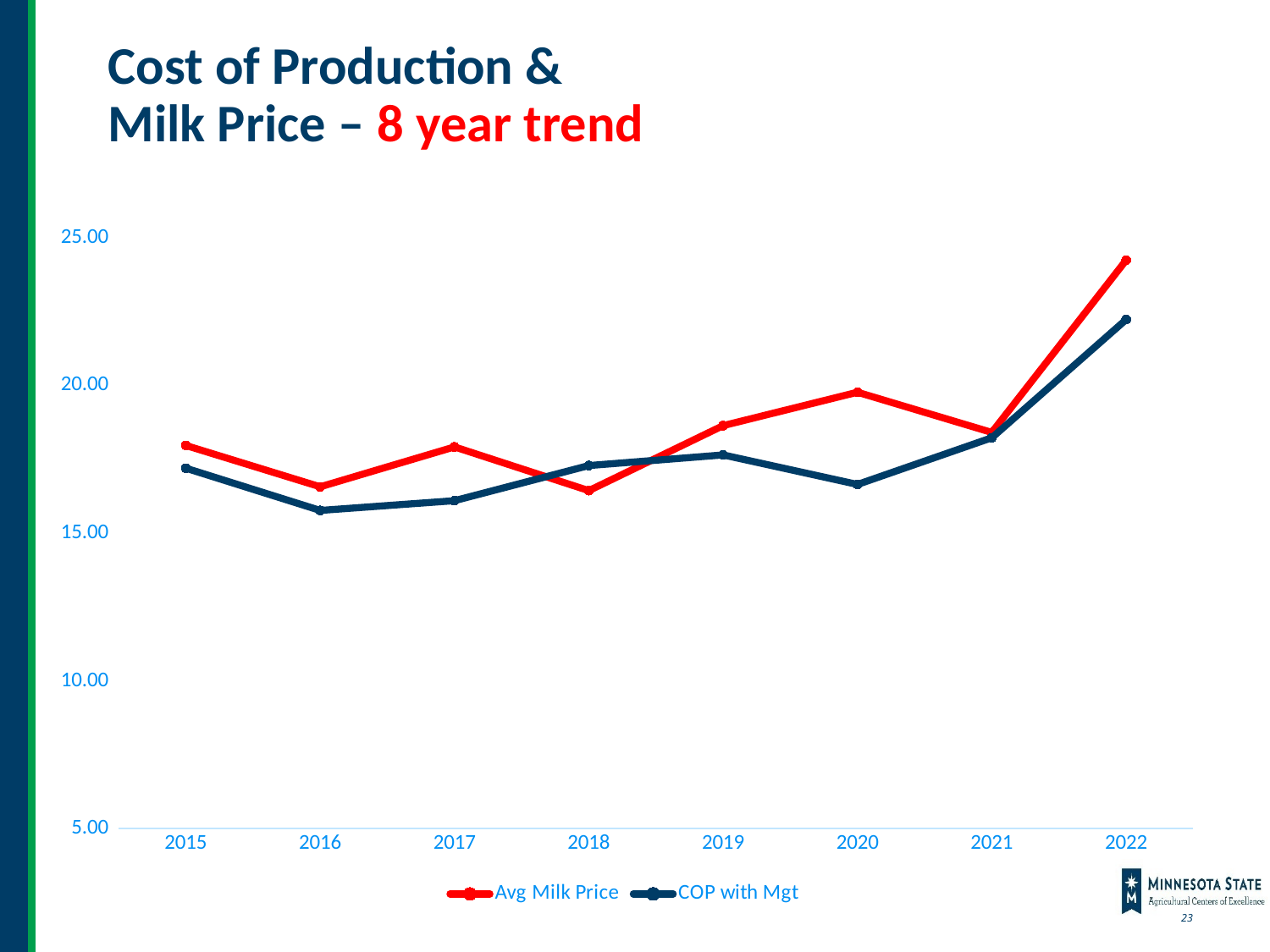
In which year is COP with Mgt highest? 2022 In which year is Avg Milk Price highest? 2022 Is the Avg Milk Price value for 2022 greater or less than 20.00? greater How many years are plotted along the x axis? 8 What kind of chart is shown on the slide? Line chart Does COP with Mgt rise or fall from 2021 to 2022? rise In 2020, which is larger: Avg Milk Price or COP with Mgt? Avg Milk Price Is the Avg Milk Price value for 2015 greater or less than 15.00? greater In 2018, which is larger: Avg Milk Price or COP with Mgt? COP with Mgt Is the COP with Mgt value for 2016 greater or less than 20.00? less What colour is the Avg Milk Price line? Red How many series does the legend list? 2